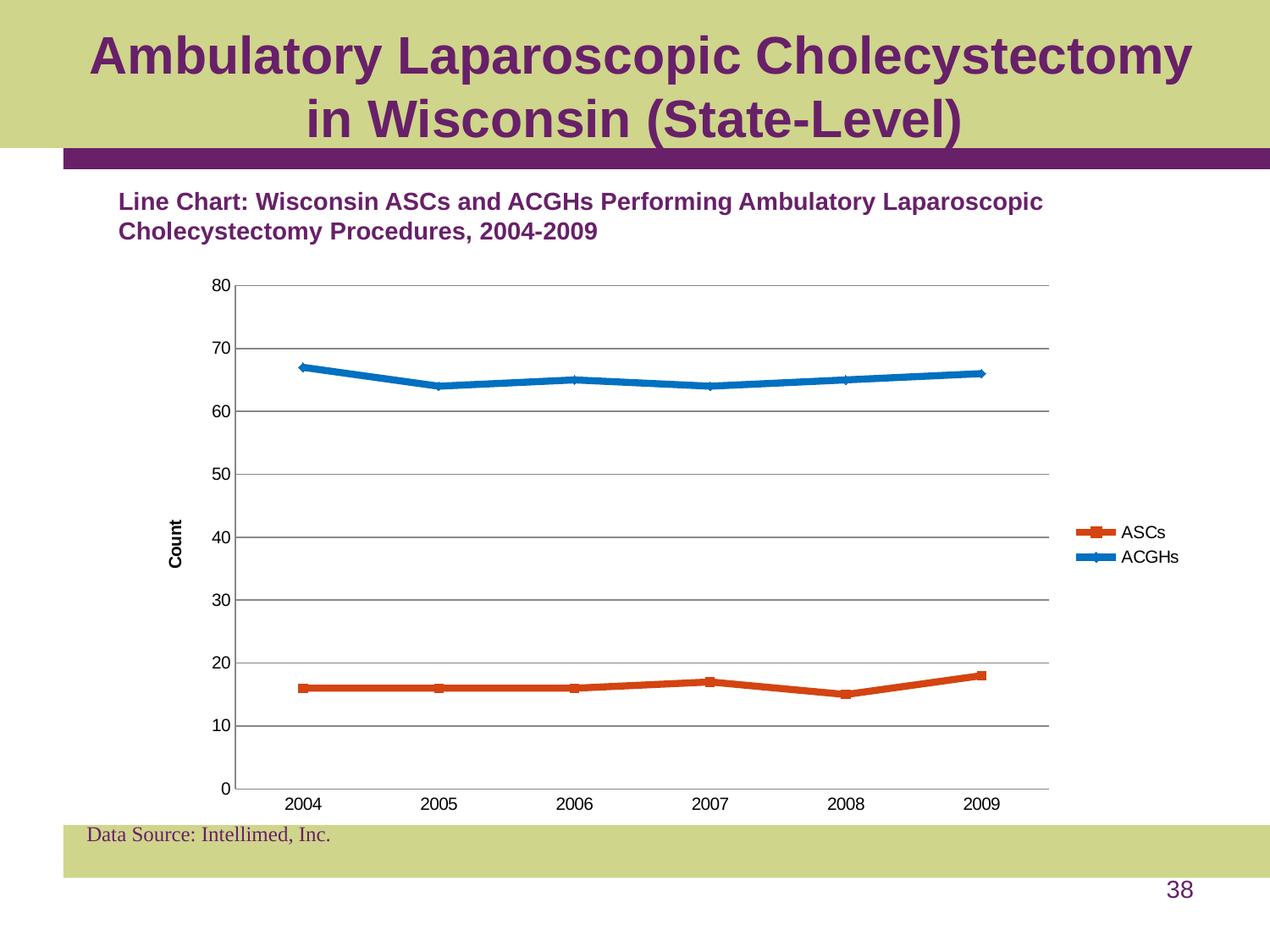
Is the value for ACGHs in 2007 greater or less than 70? less What is the label on the y axis? Count Which series is drawn in blue? ACGHs Is the value for ASCs in 2008 greater or less than 20? less How many years are plotted along the x axis? 6 What kind of chart is shown on the slide? Line chart Does the ACGHs line rise or fall from 2004 to 2005? fall How many series does the legend list? 2 Is the value for ASCs in 2009 greater or less than 10? greater Does the ASCs line rise or fall from 2008 to 2009? rise Which series has the higher value in 2006, ASCs or ACGHs? ACGHs